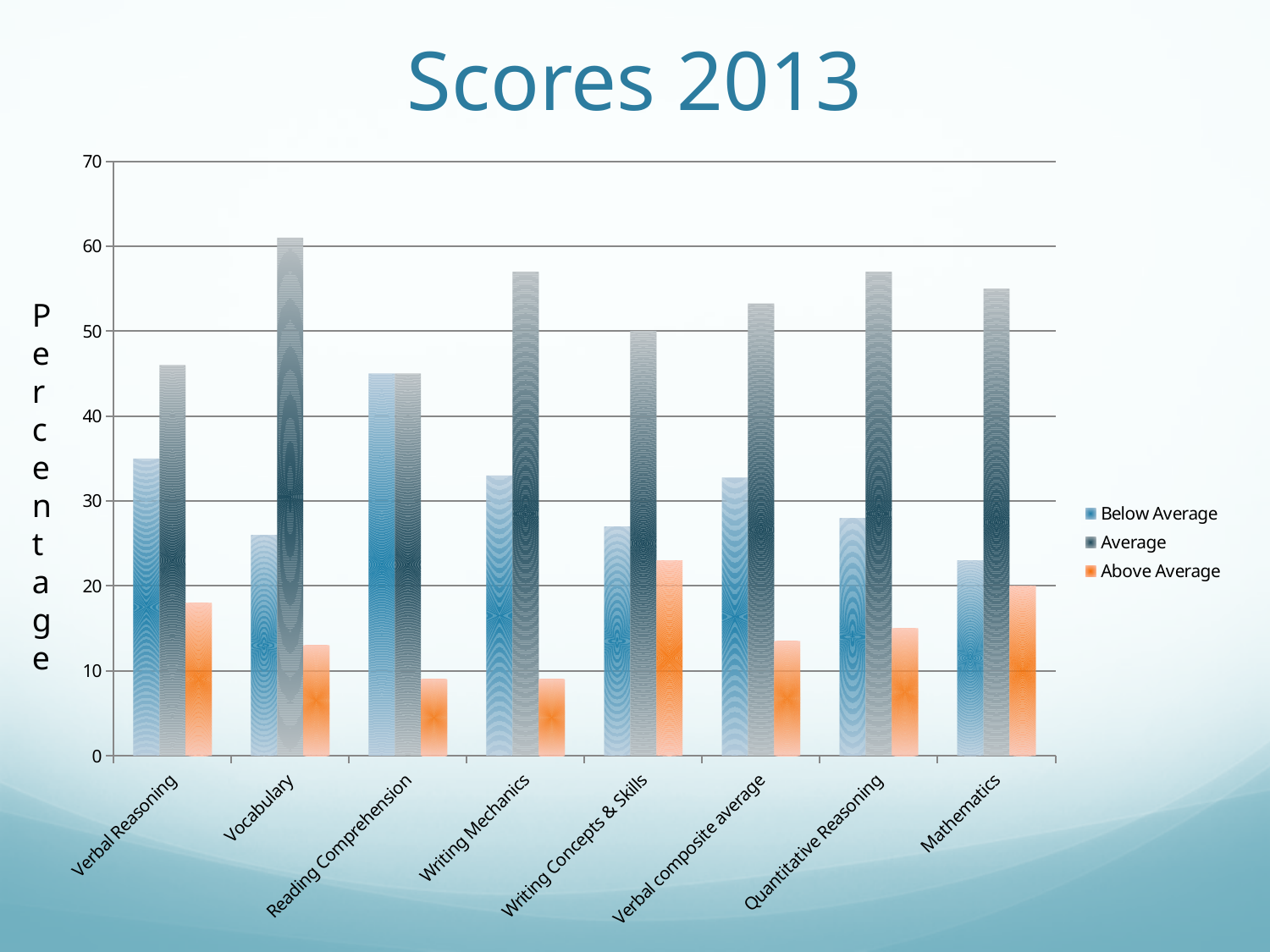
How many series does the legend list? 3 Is the Above Average value for Reading Comprehension greater or less than 10? less Is the Below Average value for Verbal Reasoning greater or less than 30? greater Which category has the highest Above Average value? Writing Concepts & Skills How many categories are shown on the x axis? 8 Which is larger for Mathematics, the Below Average value or the Above Average value? Below Average What kind of chart is shown on the slide? bar chart Is the Average value for Vocabulary greater or less than 60? greater What is the title of the chart? Scores 2013 Which category has the highest Below Average value? Reading Comprehension Which category has the highest Average value? Vocabulary Which is larger, the Average value for Writing Mechanics or the Average value for Verbal Reasoning? Writing Mechanics